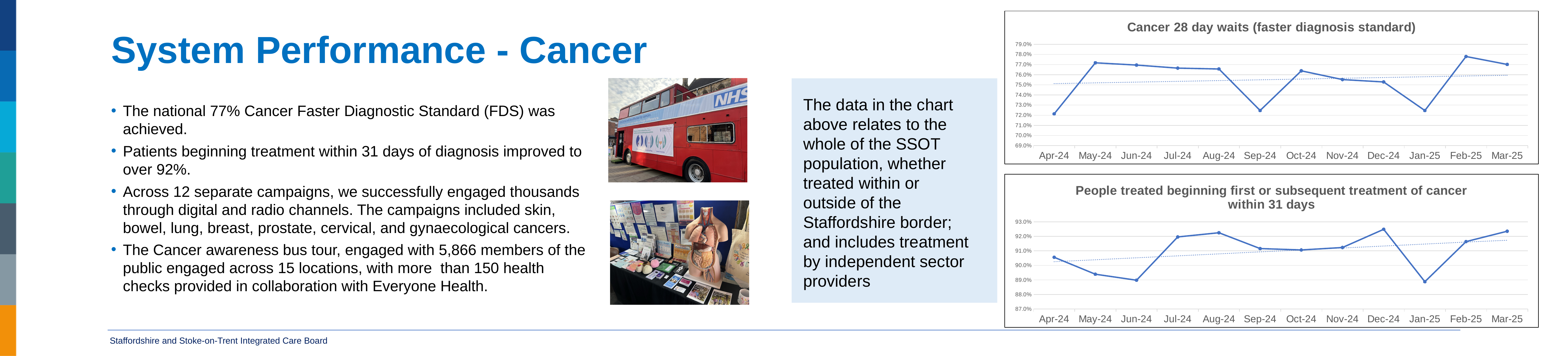
What kind of chart is the 'People treated beginning first or subsequent treatment of cancer within 31 days' chart? line chart In the 'People treated beginning first or subsequent treatment of cancer within 31 days' chart, is the value for Jan-25 greater or less than 90.0%? less In the 'People treated beginning first or subsequent treatment of cancer within 31 days' chart, is the value for Jul-24 greater or less than 91.0%? greater In the 'People treated beginning first or subsequent treatment of cancer within 31 days' chart, which is larger, the value for Dec-24 or the value for Jan-25? Dec-24 What kind of chart is the 'Cancer 28 day waits (faster diagnosis standard)' chart? line chart How many months are plotted on the 'People treated beginning first or subsequent treatment of cancer within 31 days' chart? 12 In the 'Cancer 28 day waits (faster diagnosis standard)' chart, is the value for Apr-24 greater or less than 75.0%? less How many months are plotted on the 'Cancer 28 day waits (faster diagnosis standard)' chart? 12 In the 'Cancer 28 day waits (faster diagnosis standard)' chart, does the value rise or fall from Apr-24 to May-24? rise In the 'Cancer 28 day waits (faster diagnosis standard)' chart, which is larger, the value for May-24 or the value for Sep-24? May-24 In the 'Cancer 28 day waits (faster diagnosis standard)' chart, which month has the highest value? Feb-25